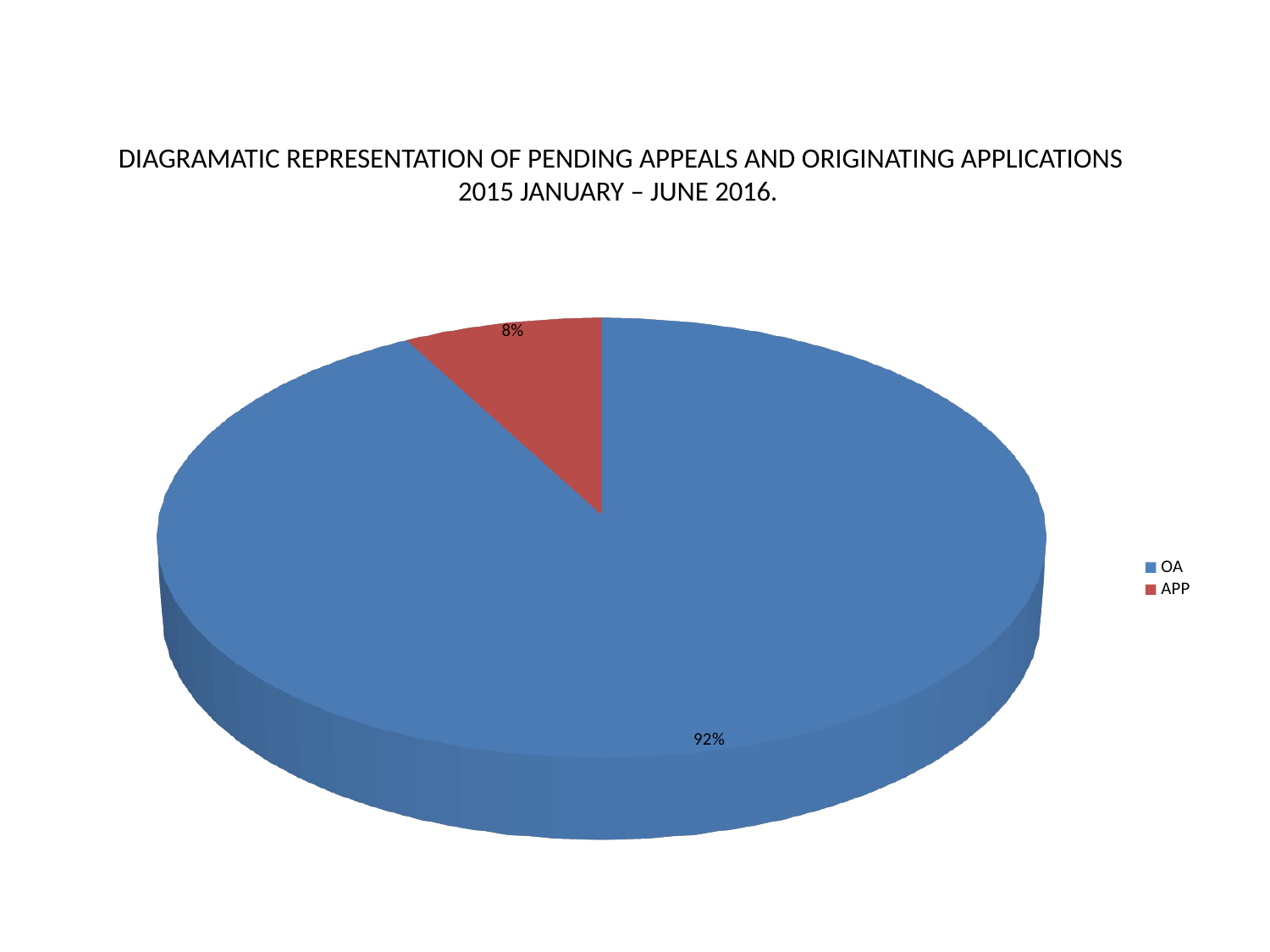
What colour is the APP slice? red How many entries does the legend list? 2 What share of the pie does APP represent? 8% How many categories does the pie chart show? 2 Which category has the smallest slice of the pie? APP What is the title of the chart? DIAGRAMATIC REPRESENTATION OF PENDING APPEALS AND ORIGINATING APPLICATIONS 2015 JANUARY – JUNE 2016. What kind of chart is shown on the slide? pie chart What share of the pie does OA represent? 92% Which category has the largest slice of the pie? OA What is the difference in percentage points between the OA and APP slices? 84 Which is larger, the OA slice or the APP slice? OA